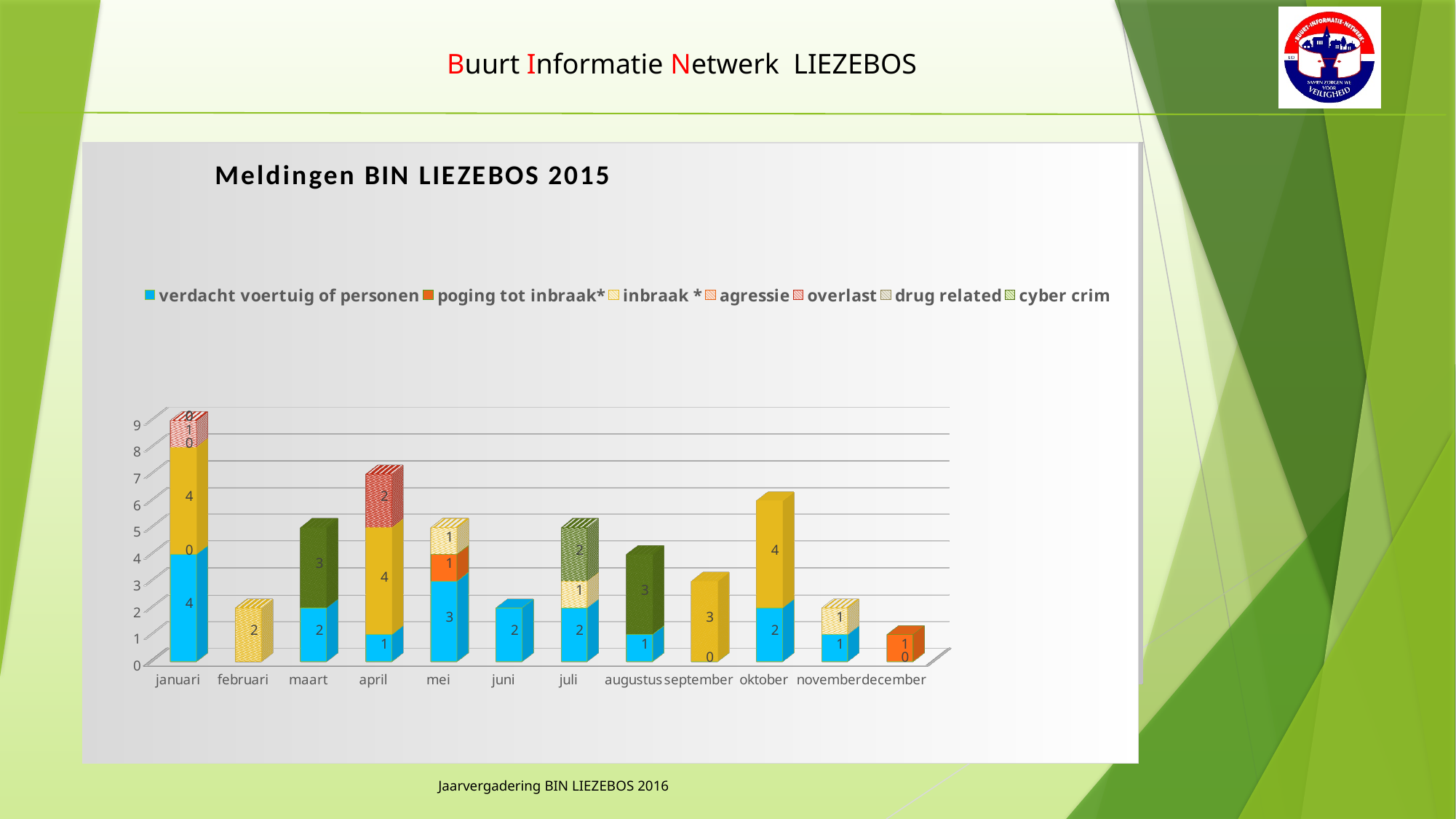
What is the value for 'verdacht voertuig of personen' in mei? 3 Which month has the tallest stacked bar overall? januari How many months (categories) are shown on the x axis? 12 Is the value for 'verdacht voertuig of personen' larger in januari or in mei? januari What is the value for 'verdacht voertuig of personen' in juni? 2 What is the total of the stacked bar for januari? 9 Which month has the shortest stacked bar overall? december What is the value for 'verdacht voertuig of personen' in januari? 4 How many series does the legend list? 7 What kind of chart is shown on the slide? stacked bar chart What is the title of the chart? Meldingen BIN LIEZEBOS 2015 What is the difference between the 'verdacht voertuig of personen' values for januari and juni? 2